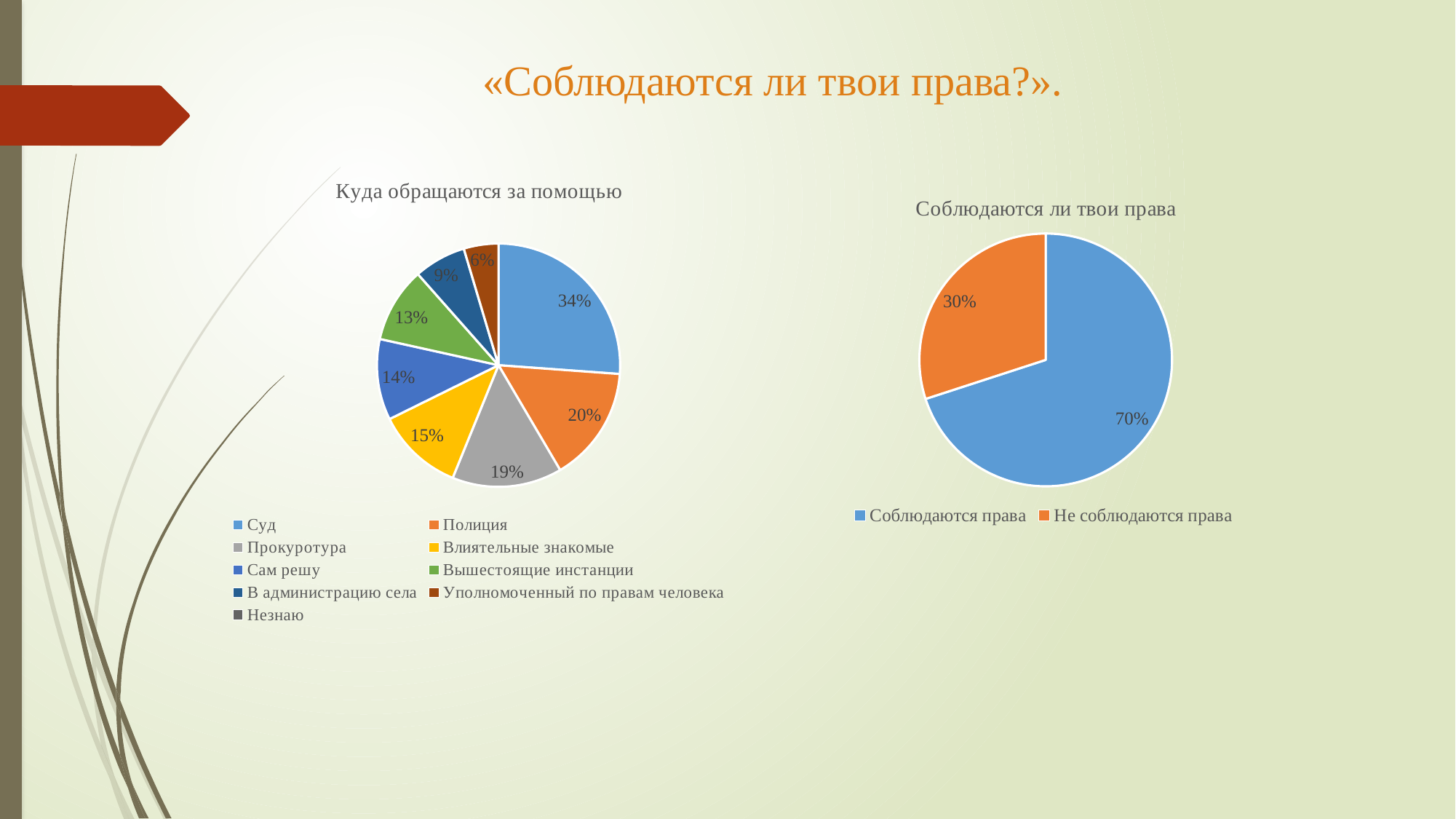
What type of chart is the one titled «Соблюдаются ли твои права»? Pie chart In the chart titled «Куда обращаются за помощью», which category has the largest slice? Суд In the chart titled «Соблюдаются ли твои права», what percentage is shown for Не соблюдаются права? 30% In the chart titled «Куда обращаются за помощью», what percentage is shown for Вышестоящие инстанции? 13% In the chart titled «Куда обращаются за помощью», how many entries does the legend list? 9 In the chart titled «Соблюдаются ли твои права», what percentage is shown for Соблюдаются права? 70% In the chart titled «Соблюдаются ли твои права», what colour is the slice for Не соблюдаются права? Orange In the chart titled «Куда обращаются за помощью», what percentage is shown for Полиция? 20% In the chart titled «Куда обращаются за помощью», what percentage is shown for Суд? 34% In the chart titled «Куда обращаются за помощью», what is the difference in percentage points between Суд and Прокуротура? 15 In the chart titled «Куда обращаются за помощью», which labelled slice is the smallest? Уполномоченный по правам человека In the chart titled «Куда обращаются за помощью», which is larger: Влиятельные знакомые or Сам решу? Влиятельные знакомые